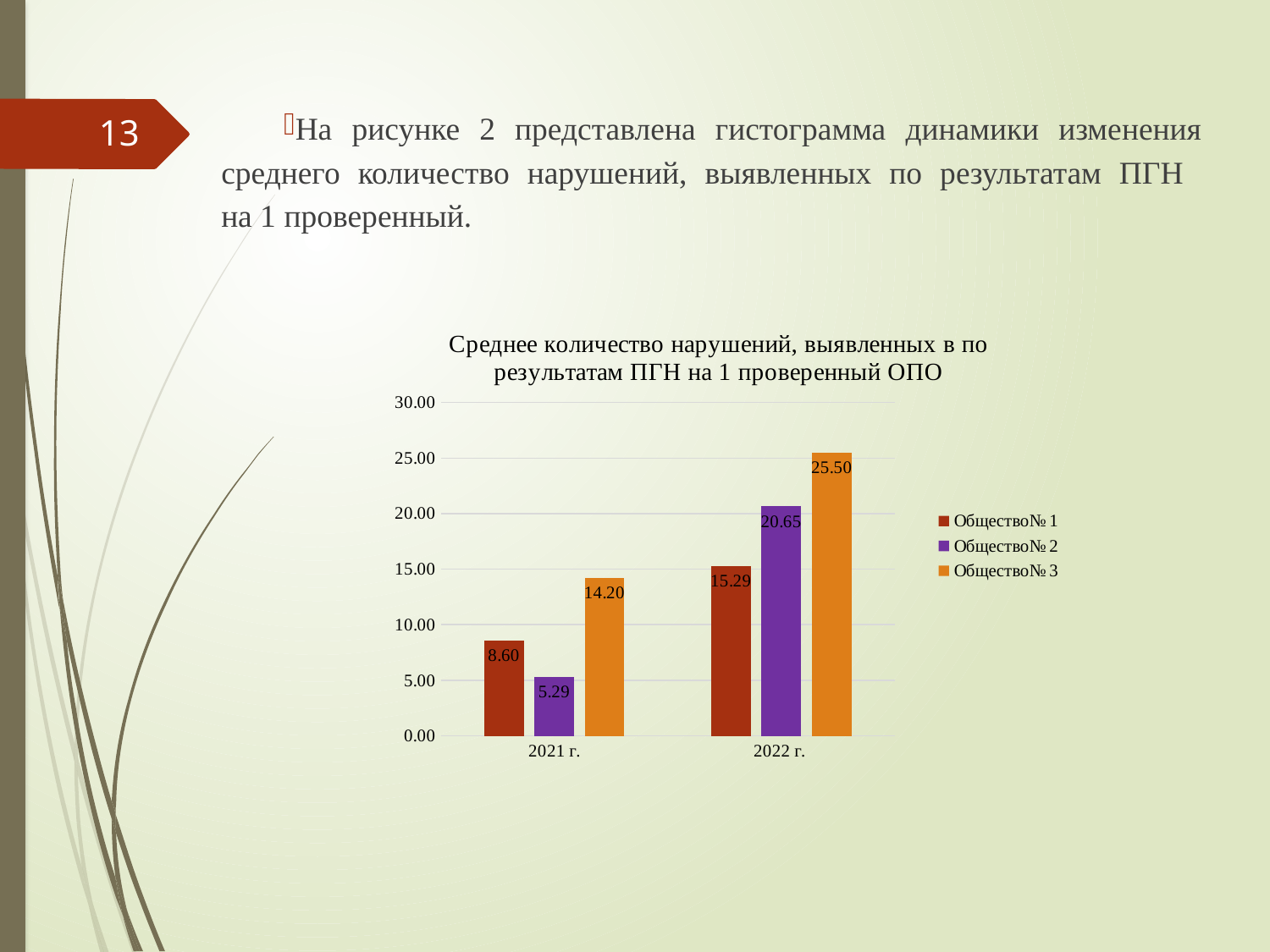
What is the difference between the values for Общество№ 3 in 2022 г. and 2021 г.? 11.30 Which series has the highest value in 2022 г.? Общество№ 3 What is the value for Общество№ 3 in 2022 г.? 25.50 How many year categories are shown on the x axis? 2 Which series has the lowest value in 2021 г.? Общество№ 2 Do the values for Общество№ 1 rise or fall from 2021 г. to 2022 г.? rise What is the value for Общество№ 2 in 2021 г.? 5.29 Is the value for Общество№ 2 in 2022 г. greater or less than 20.00? greater Which is larger: Общество№ 1 in 2022 г. or Общество№ 3 in 2021 г.? Общество№ 1 in 2022 г. What is the value for Общество№ 1 in 2021 г.? 8.60 What kind of chart is shown on the slide? bar chart How many series does the legend list? 3